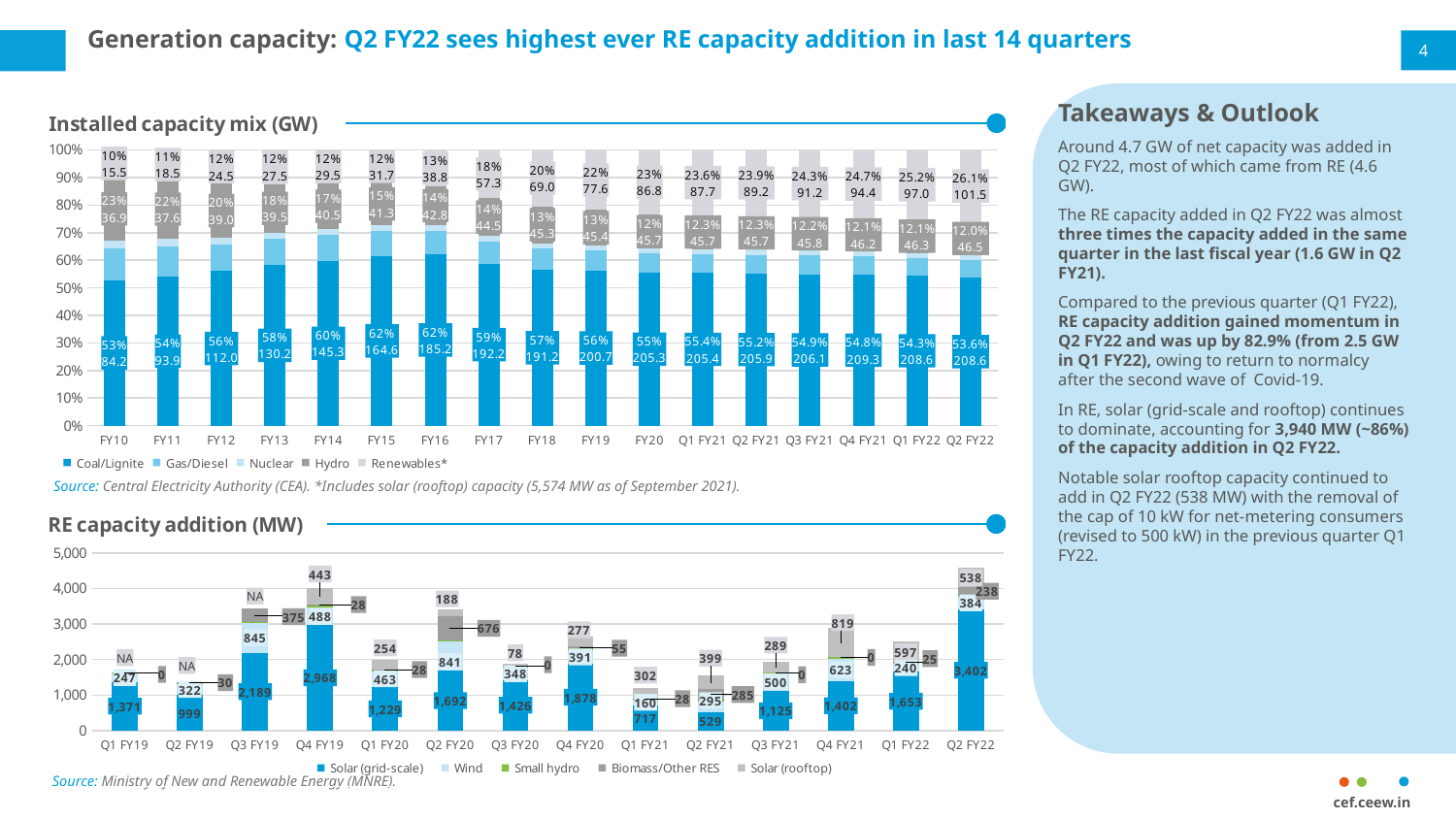
In the 'RE capacity addition (MW)' chart, what was the Solar (grid-scale) capacity addition in Q2 FY22? 3,402 In the 'RE capacity addition (MW)' chart, what was the Solar (rooftop) addition in Q4 FY21? 819 In the 'Installed capacity mix (GW)' chart, what share of installed capacity did Renewables account for in Q2 FY22? 26.1% In the 'RE capacity addition (MW)' chart, which is larger: the Wind addition in Q4 FY21 or in Q1 FY22? Q4 FY21 In the 'RE capacity addition (MW)' chart, which quarter had the lowest Solar (grid-scale) addition? Q2 FY21 In the 'RE capacity addition (MW)' chart, which quarter had the highest Solar (grid-scale) addition? Q2 FY22 In the 'RE capacity addition (MW)' chart, how many quarters are shown on the x axis? 14 In the 'Installed capacity mix (GW)' chart, how many series does the legend list? 5 What type of chart is the 'Installed capacity mix (GW)' chart? Stacked bar chart In the 'Installed capacity mix (GW)' chart, what was the Coal/Lignite capacity in GW in FY16? 185.2 In the 'Installed capacity mix (GW)' chart, does the Renewables share rise or fall from FY10 to Q2 FY22? Rise In the 'Installed capacity mix (GW)' chart, what is the difference in Renewables capacity (GW) between Q2 FY22 and Q1 FY22? 4.5